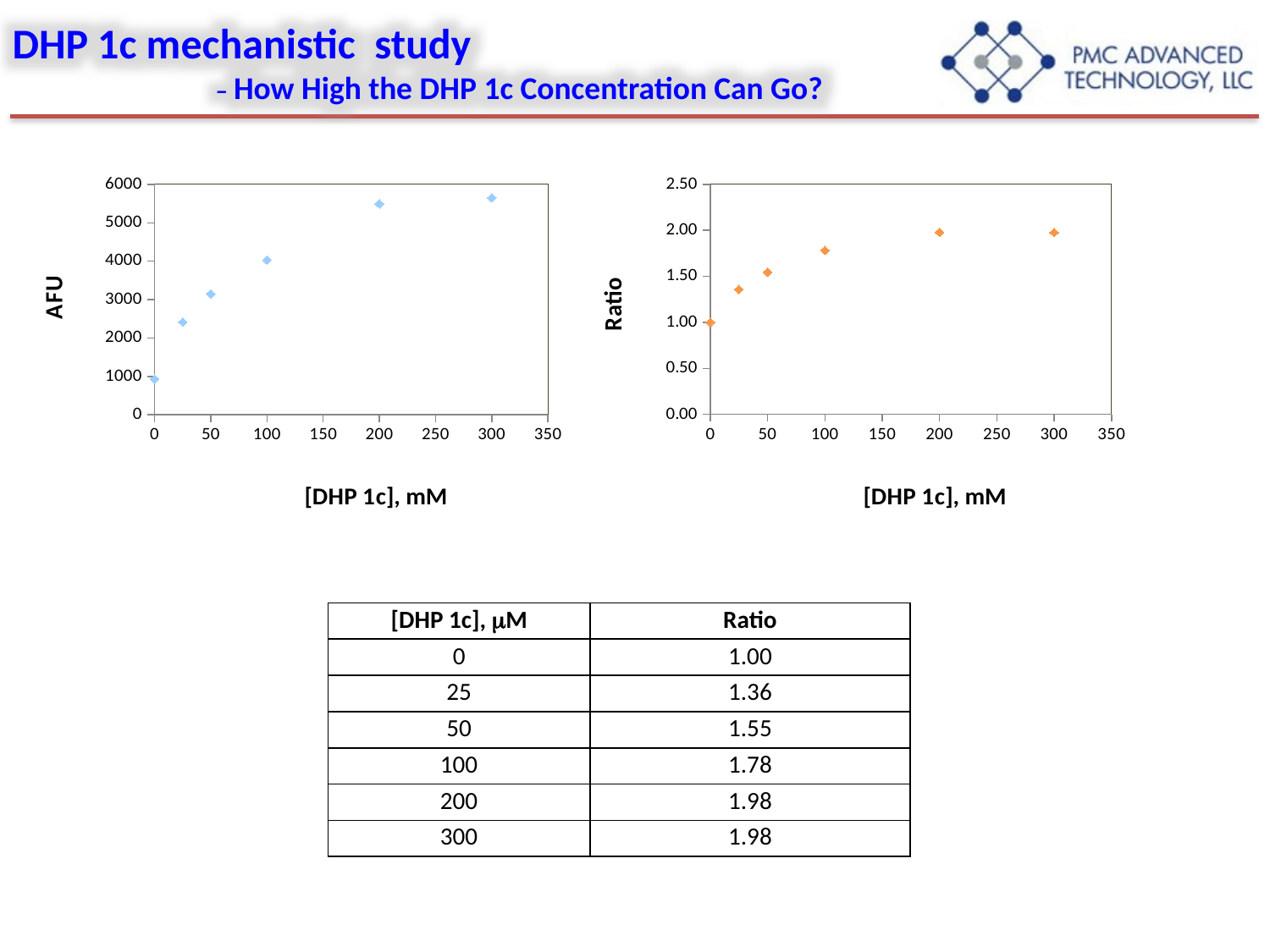
In the right chart (Ratio), what is the difference between the Ratio at 200 and the Ratio at 0? 0.98 In the right chart (Ratio), which has the larger Ratio: [DHP 1c] = 50 or [DHP 1c] = 100? 100 What type of chart is the left chart (AFU vs [DHP 1c])? scatter chart How many data points are plotted in the right chart (Ratio)? 6 In the left chart (AFU), do the values rise or fall as [DHP 1c] increases? rise In the right chart (Ratio), what is the Ratio at [DHP 1c] = 25? 1.36 In the left chart (AFU), is the value at [DHP 1c] = 100 greater or less than 3000? greater In the right chart (Ratio), what is the Ratio at [DHP 1c] = 100? 1.78 What is the y-axis label of the left chart? AFU In the right chart (Ratio), at which concentration is the Ratio lowest? 0 In the left chart (AFU), is the value at [DHP 1c] = 200 greater or less than 5000? greater